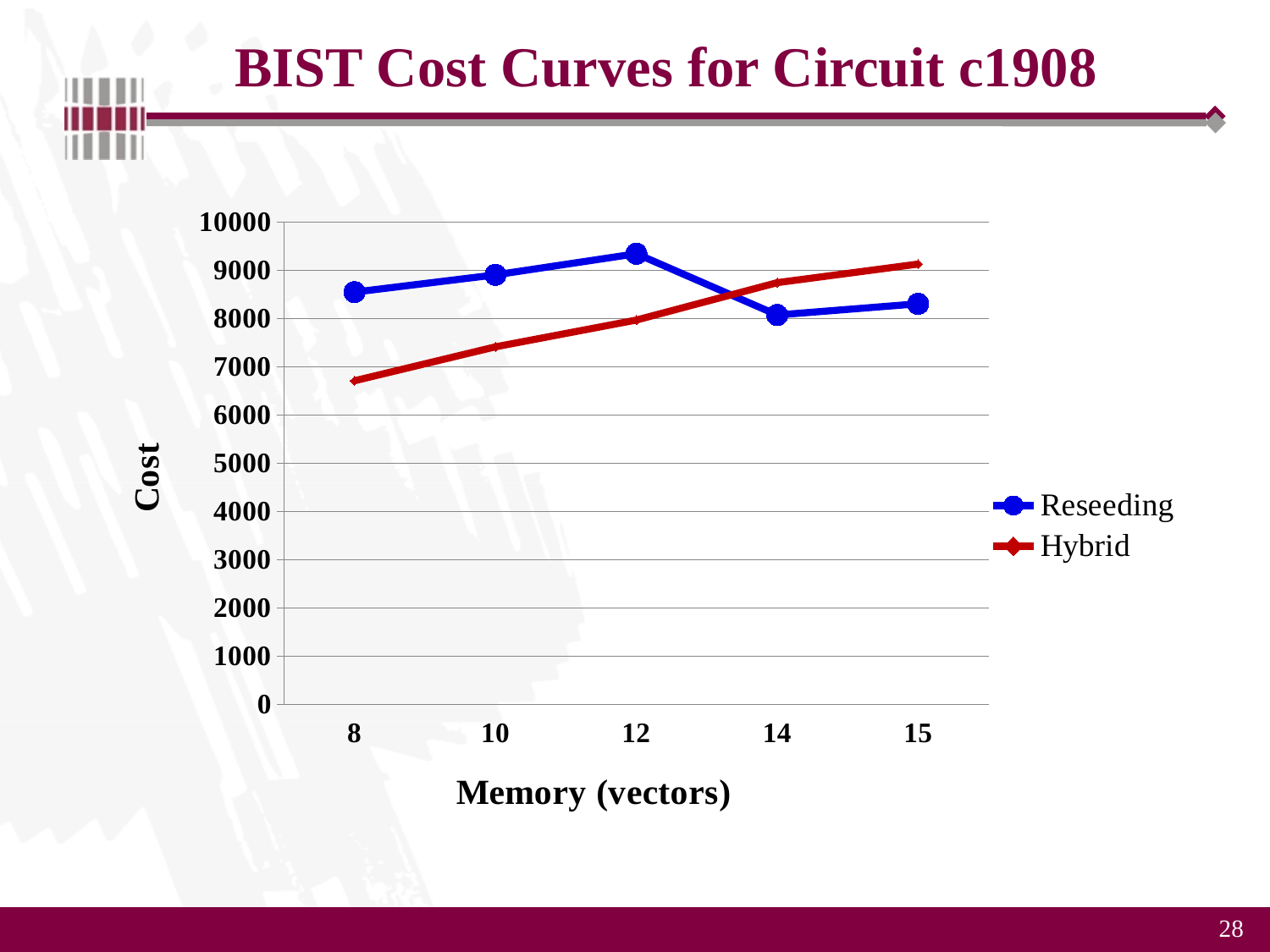
How many series does the legend list? 2 At which memory value is the Reseeding cost highest? 12 What kind of chart is shown on the slide? line chart At 8 memory vectors, which series has the higher cost, Reseeding or Hybrid? Reseeding At 15 memory vectors, which series has the higher cost, Reseeding or Hybrid? Hybrid Is the Reseeding cost at 12 memory vectors greater or less than 9000? greater Does the Hybrid cost rise or fall as memory increases from 8 to 15 vectors? rise At which memory value is the Hybrid cost lowest? 8 At which memory value is the Reseeding cost lowest? 14 How many memory values are plotted along the x axis? 5 Is the Hybrid cost at 8 memory vectors greater or less than 7000? less At which memory value is the Hybrid cost highest? 15